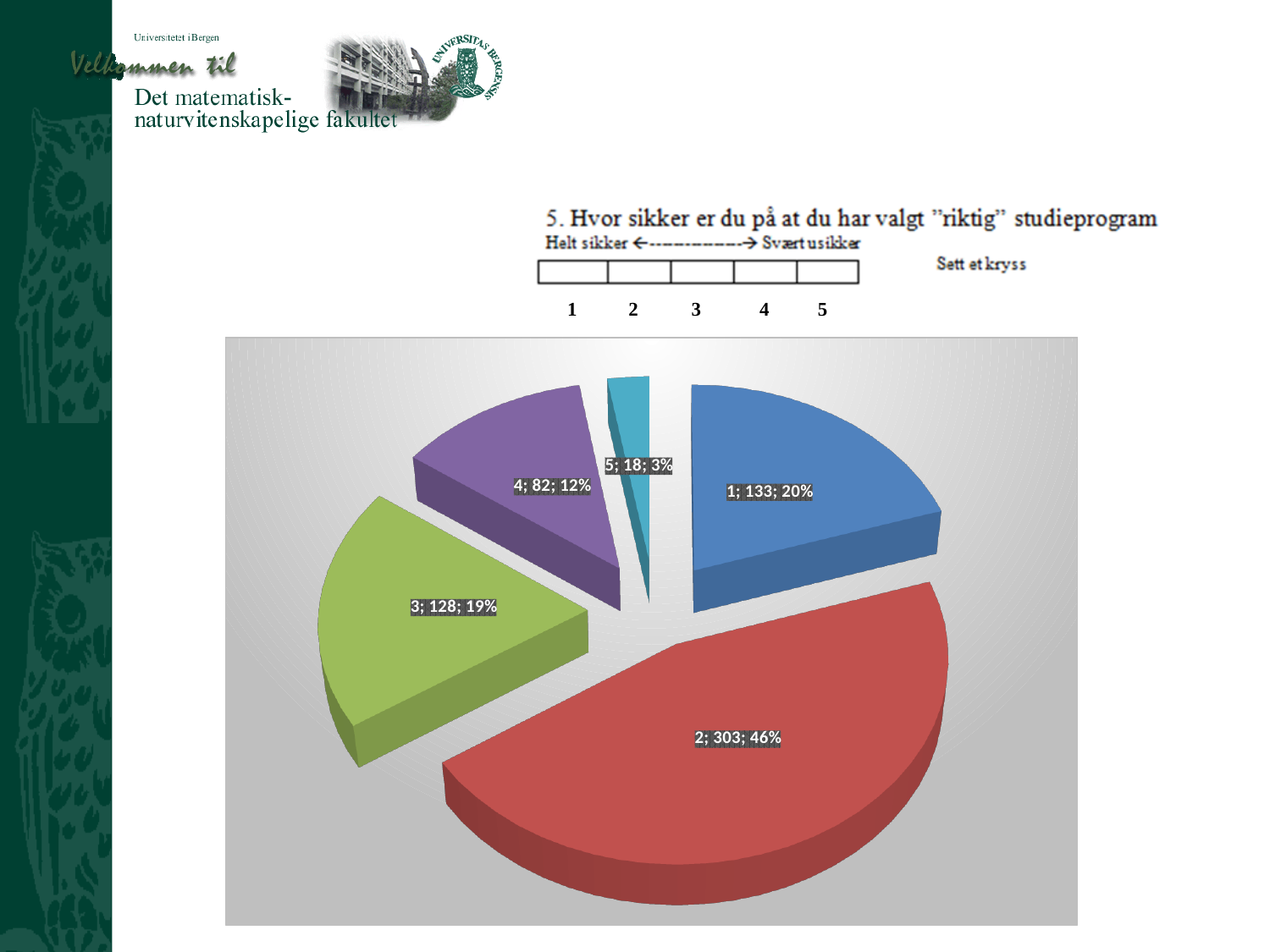
What is the count for category 5 in the pie chart? 18 Which category has the smallest slice in the pie chart? 5 What percentage share does category 3 have in the pie chart? 19% What is the count for category 2 in the pie chart? 303 What is the count for category 1 in the pie chart? 133 What percentage share does category 4 have in the pie chart? 12% Which has a larger count in the pie chart, category 3 or category 4? 3 What kind of chart is shown on the slide? pie chart What is the difference between the counts for category 2 and category 1 in the pie chart? 170 Which category has the largest slice in the pie chart? 2 How many slices does the pie chart have? 5 What colour is the slice for category 2 in the pie chart? red